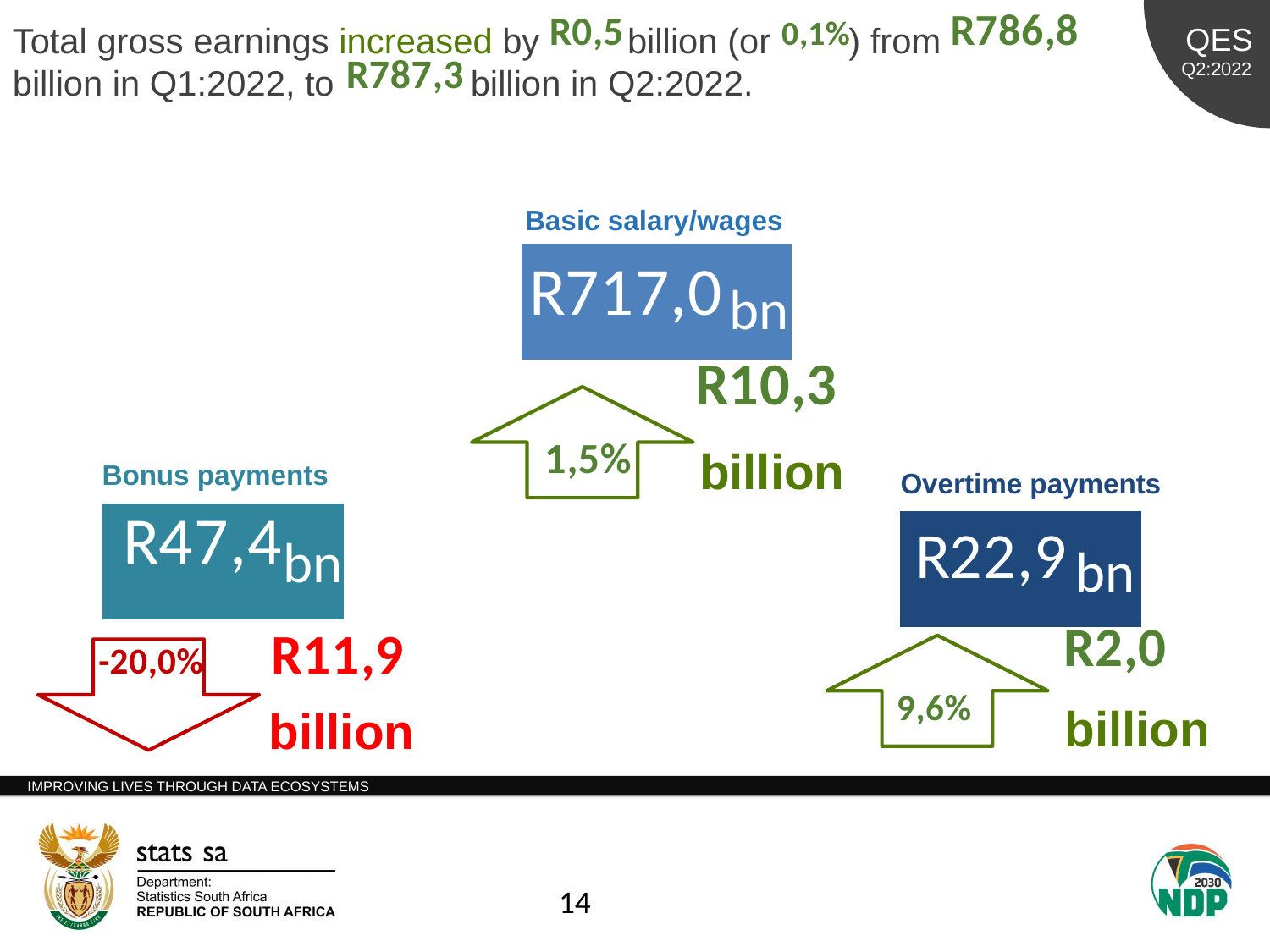
What is the difference between the Bonus payments value and the Overtime payments value? R24,5 bn Which is larger, Bonus payments or Overtime payments? Bonus payments What is the value shown for Basic salary/wages? R717,0 bn Which earnings component has the highest value? Basic salary/wages By what amount did Overtime payments increase? R2,0 billion How many earnings components are shown on the slide? 3 By what percentage did Bonus payments change? -20,0% Which earnings component decreased from Q1:2022 to Q2:2022? Bonus payments What is the value shown for Overtime payments? R22,9 bn By what percentage did Basic salary/wages increase? 1,5% Which earnings component has the lowest value? Overtime payments What is the value shown for Bonus payments? R47,4 bn